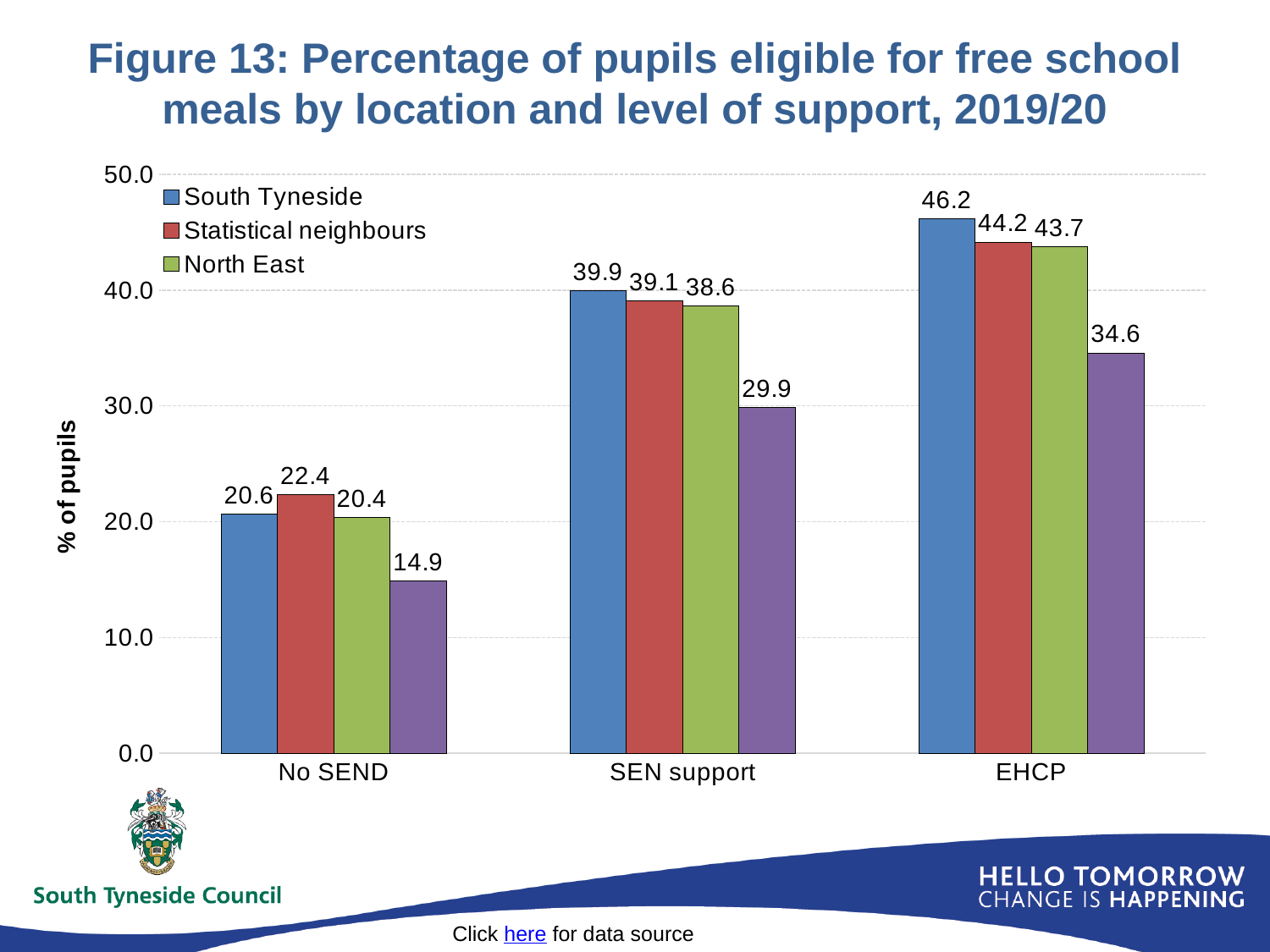
In which category is the North East value lowest? No SEND What is the value for Statistical neighbours in the No SEND category? 22.4 In the No SEND category, which is larger: South Tyneside or Statistical neighbours? Statistical neighbours In which category is the South Tyneside value highest? EHCP What kind of chart is shown on the slide? bar chart What is the value for North East in the EHCP category? 43.7 How many categories are shown on the x axis? 3 Is the value for North East in the SEN support category greater or less than 40.0? less What is the difference between the South Tyneside and Statistical neighbours values in the EHCP category? 2.0 Do the South Tyneside values rise or fall from No SEND to EHCP? rise What is the value for South Tyneside in the SEN support category? 39.9 How many series does the legend list? 3